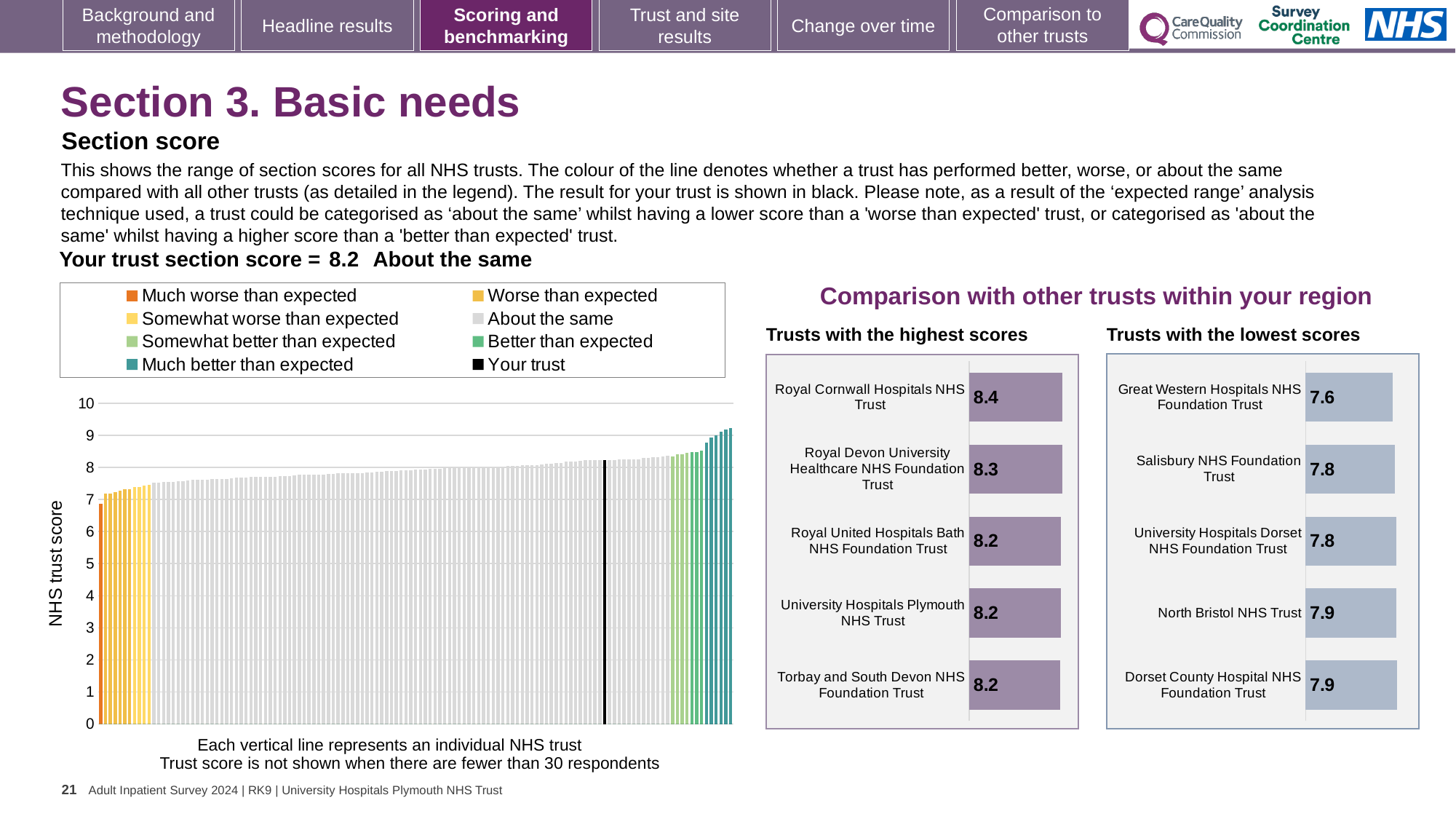
In the 'Trusts with the highest scores' chart, which trust has the highest score? Royal Cornwall Hospitals NHS Trust In the NHS trust score chart on the left, do the values rise or fall from left to right along the x axis? Rise In the 'Trusts with the lowest scores' chart, what is the difference between the scores of Salisbury NHS Foundation Trust and Great Western Hospitals NHS Foundation Trust? 0.2 In the 'Trusts with the highest scores' chart, what is the difference between the scores of Royal Cornwall Hospitals NHS Trust and Torbay and South Devon NHS Foundation Trust? 0.2 In the 'Trusts with the highest scores' chart, what is the score for University Hospitals Plymouth NHS Trust? 8.2 Comparing the two regional charts, which has the higher score: Royal Devon University Healthcare NHS Foundation Trust or North Bristol NHS Trust? Royal Devon University Healthcare NHS Foundation Trust How many entries does the legend of the NHS trust score chart on the left list? 8 In the 'Trusts with the highest scores' chart, what is the score for Royal Cornwall Hospitals NHS Trust? 8.4 In the 'Trusts with the lowest scores' chart, what is the score for Great Western Hospitals NHS Foundation Trust? 7.6 How many trusts are listed in the 'Trusts with the highest scores' chart? 5 In the 'Trusts with the lowest scores' chart, which trust has the lowest score? Great Western Hospitals NHS Foundation Trust What kind of chart is the NHS trust score chart on the left of the slide? Bar chart